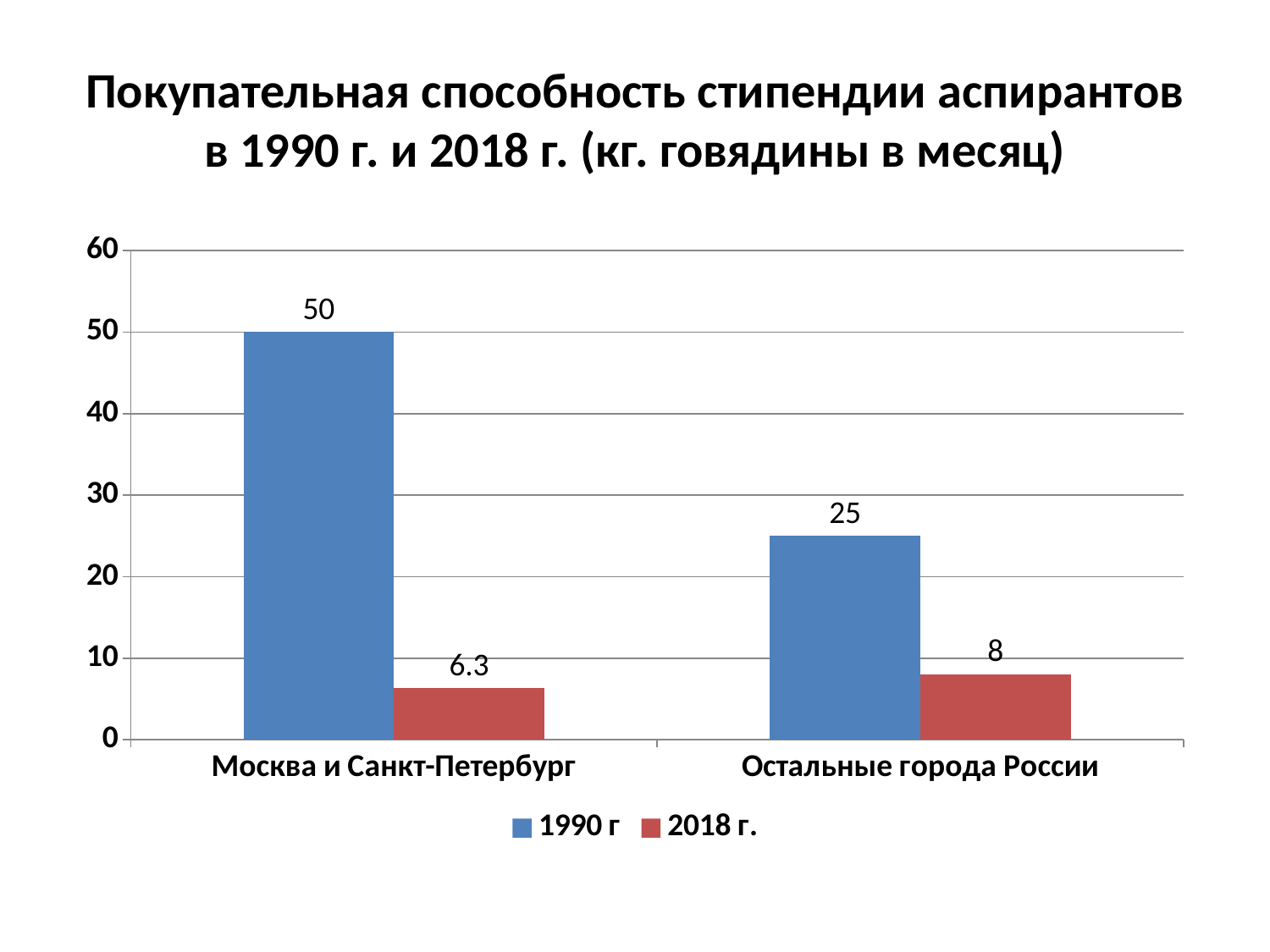
What is the value for 1990 г for Остальные города России? 25 What is the difference between the 1990 г and 2018 г. values for Остальные города России? 17 How many series does the legend list? 2 What is the value for 2018 г. for Остальные города России? 8 What kind of chart is shown on the slide? Bar chart Which is larger: the 2018 г. value for Москва и Санкт-Петербург or the 2018 г. value for Остальные города России? Остальные города России Which category has the highest value for 1990 г? Москва и Санкт-Петербург What is the title of the chart? Покупательная способность стипендии аспирантов в 1990 г. и 2018 г. (кг. говядины в месяц) What is the value for 2018 г. for Москва и Санкт-Петербург? 6.3 How many categories are shown on the x axis? 2 Which category has the lowest value for 2018 г.? Москва и Санкт-Петербург What is the value for 1990 г for Москва и Санкт-Петербург? 50